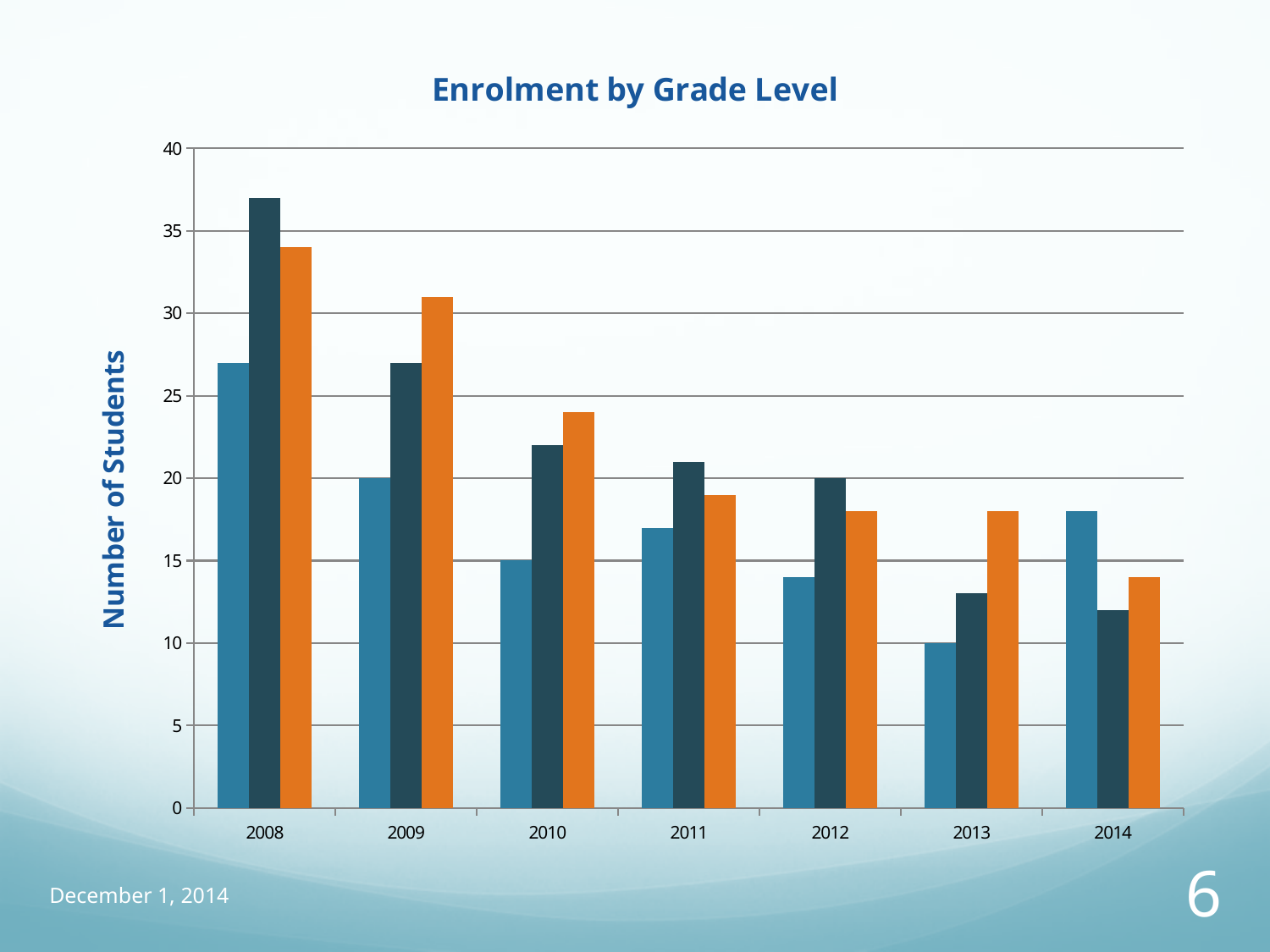
What is the value of the light blue bar for 2009? 20 In which year is the dark teal bar the highest? 2008 What is the value of the light blue bar for 2013? 10 What is the value of the dark teal bar for 2012? 20 What is the title of the chart? Enrolment by Grade Level What is the difference between the light blue bar for 2009 and the light blue bar for 2010? 5 What is the label on the vertical axis of the chart? Number of Students For 2013, which is larger, the orange bar or the dark teal bar? The orange bar What kind of chart is shown on the slide? Bar chart In which year is the orange bar the lowest? 2014 How many years are shown along the x axis of the chart? 7 Is the value of the dark teal bar for 2008 greater or less than 35? greater